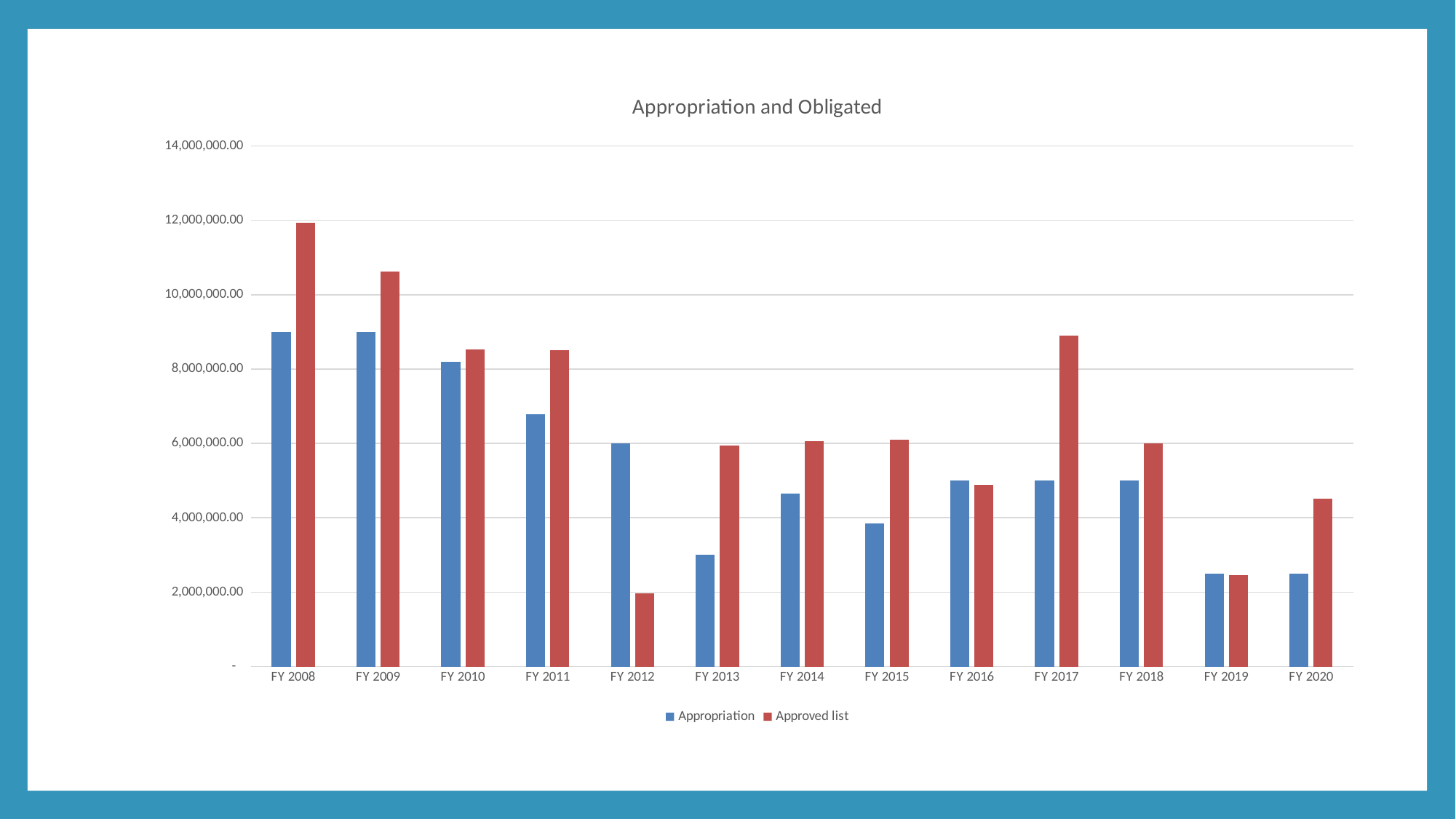
Which fiscal year has the highest Approved list value? FY 2008 Which fiscal year has the lowest Approved list value? FY 2012 How many series does the legend list? 2 Which fiscal year has the lowest Appropriation value? FY 2019 and FY 2020 (tied) In FY 2017, which is larger, Appropriation or Approved list? Approved list What kind of chart is shown on the slide? bar chart What is the title of the chart? Appropriation and Obligated Is the Approved list value for FY 2009 greater or less than 10,000,000.00? greater Is the Appropriation value for FY 2013 greater or less than 4,000,000.00? less In FY 2012, which is larger, Appropriation or Approved list? Appropriation How many fiscal years are shown on the x axis? 13 Which colour represents the Approved list series in the legend? red